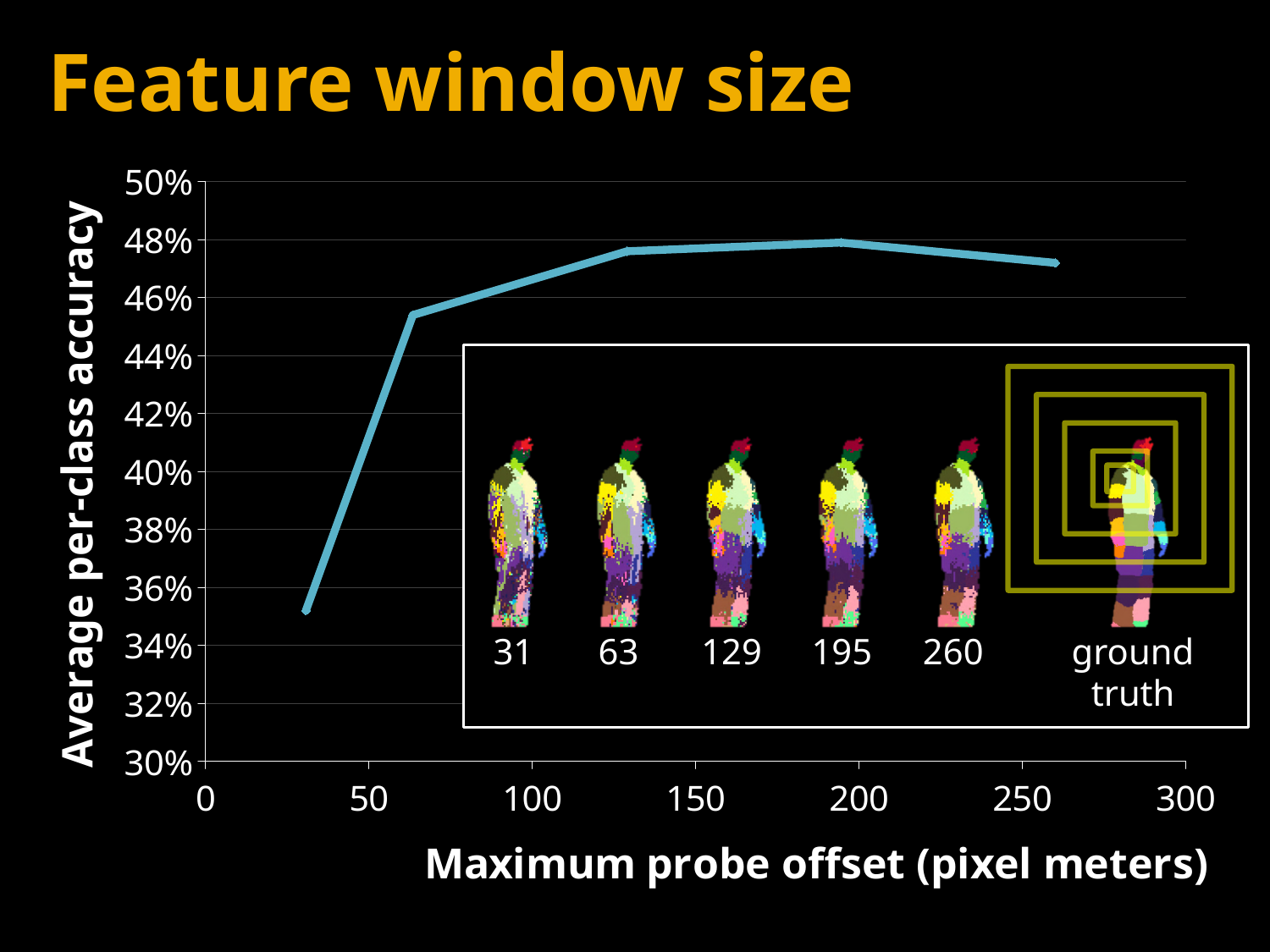
What is the title of the slide containing the chart? Feature window size Does the average per-class accuracy rise or fall as the maximum probe offset increases from 31 to 63? rise Is the average per-class accuracy at a maximum probe offset of 63 greater or less than 44%? greater How many data points are plotted on the line? 5 Which has the higher average per-class accuracy: a maximum probe offset of 63 or 129? 129 At which maximum probe offset is the average per-class accuracy lowest? 31 What is the label of the x axis of the chart? Maximum probe offset (pixel meters) Which has the higher average per-class accuracy: a maximum probe offset of 31 or 260? 260 Is the average per-class accuracy at a maximum probe offset of 31 greater or less than 36%? less Is the average per-class accuracy at a maximum probe offset of 260 greater or less than 48%? less What kind of chart is shown on the slide? line chart